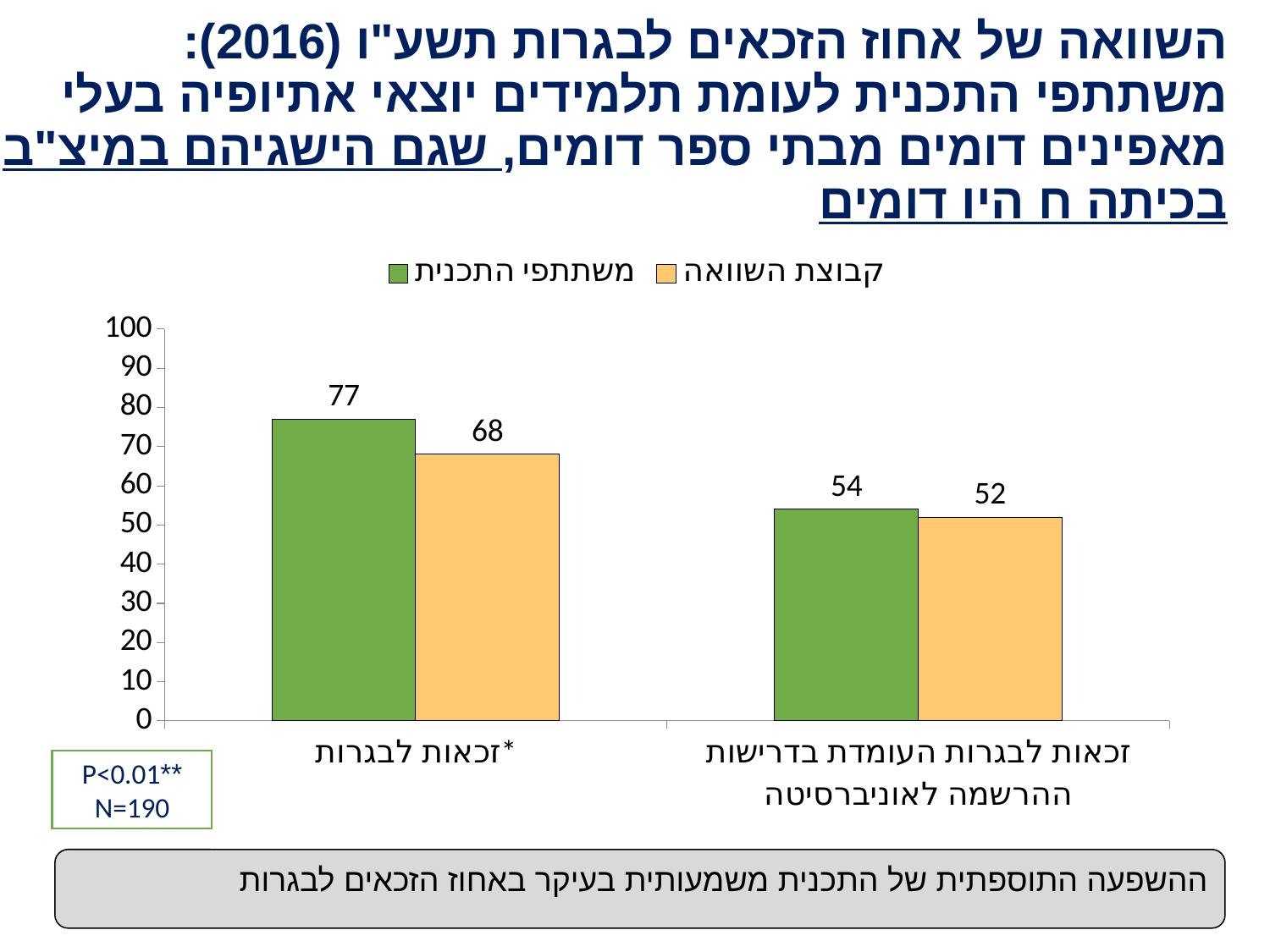
How many series does the legend list? 2 Which is larger in the category זכאות לבגרות: משתתפי התכנית or קבוצת השוואה? משתתפי התכנית What is the value for קבוצת השוואה in the category זכאות לבגרות? 68 Which bar has the lowest value on the chart? קבוצת השוואה, זכאות לבגרות העומדת בדרישות ההרשמה לאוניברסיטה What is the difference between משתתפי התכנית and קבוצת השוואה in the category זכאות לבגרות? 9 Which bar has the highest value on the chart? משתתפי התכנית, זכאות לבגרות What is the difference between משתתפי התכנית and קבוצת השוואה in the category זכאות לבגרות העומדת בדרישות ההרשמה לאוניברסיטה? 2 What is the value for משתתפי התכנית in the category זכאות לבגרות? 77 What is the value for משתתפי התכנית in the category זכאות לבגרות העומדת בדרישות ההרשמה לאוניברסיטה? 54 What is the value for קבוצת השוואה in the category זכאות לבגרות העומדת בדרישות ההרשמה לאוניברסיטה? 52 What kind of chart is shown on the slide? Bar chart How many categories are shown on the x axis of the chart? 2